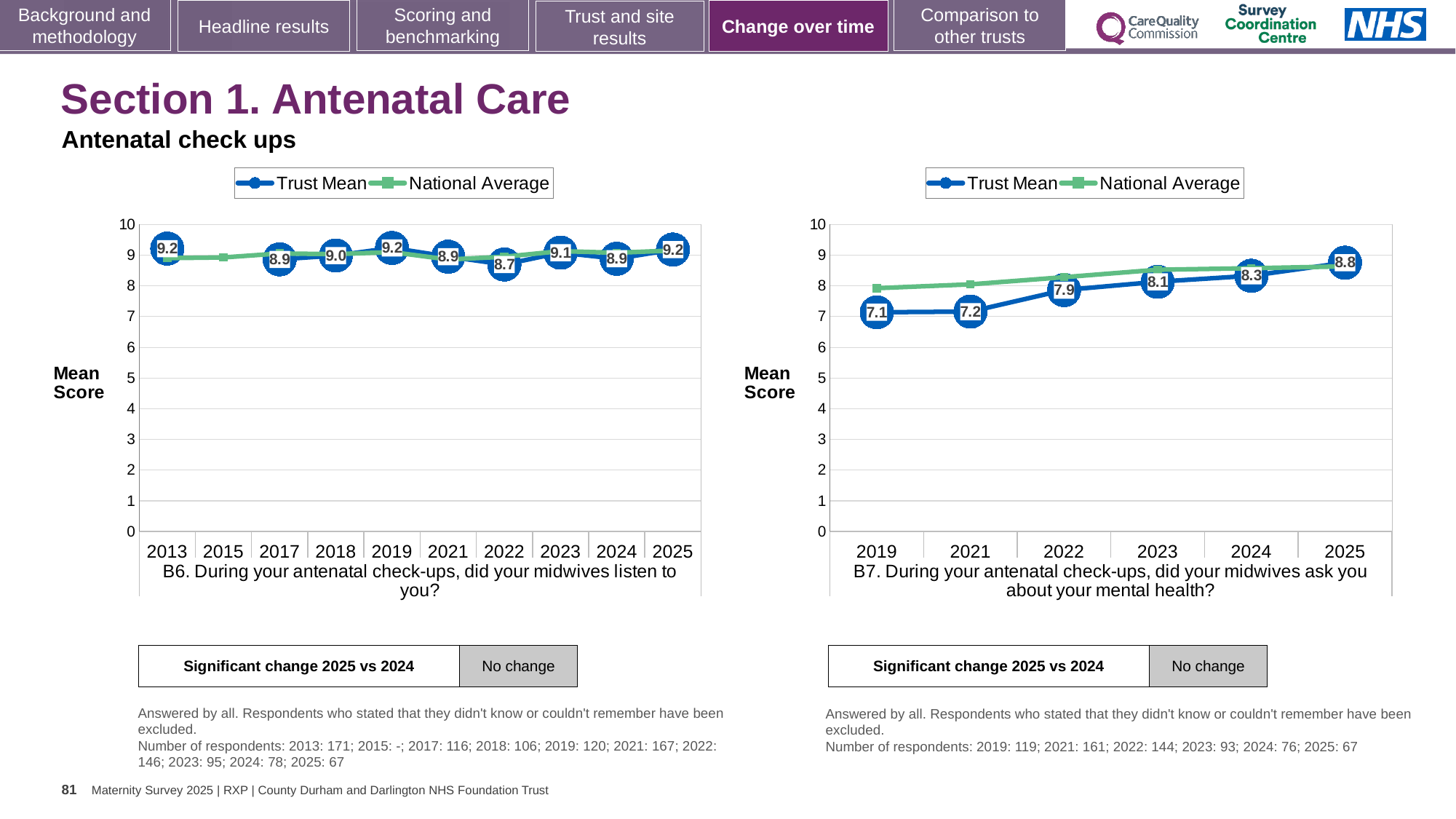
In the B6 chart (left), what is the Trust Mean for 2025? 9.2 In the B7 chart (right), does the Trust Mean rise or fall from 2019 to 2025? rise In the B7 chart (right), what is the difference between the Trust Mean in 2025 and in 2019? 1.7 What kind of chart is the B6 chart (left)? line chart How many years are shown on the x axis of the B6 chart (left)? 10 In the B6 chart (left), what is the difference between the Trust Mean in 2025 and in 2022? 0.5 In the B7 chart (right), which year has the highest Trust Mean? 2025 How many series does the legend of the B7 chart (right) list? 2 In the B7 chart (right), is the National Average for 2019 greater or less than 7? greater In the B6 chart (left), what is the Trust Mean for 2022? 8.7 In the B7 chart (right), what is the Trust Mean for 2019? 7.1 In the B6 chart (left), which year has the lowest Trust Mean? 2022